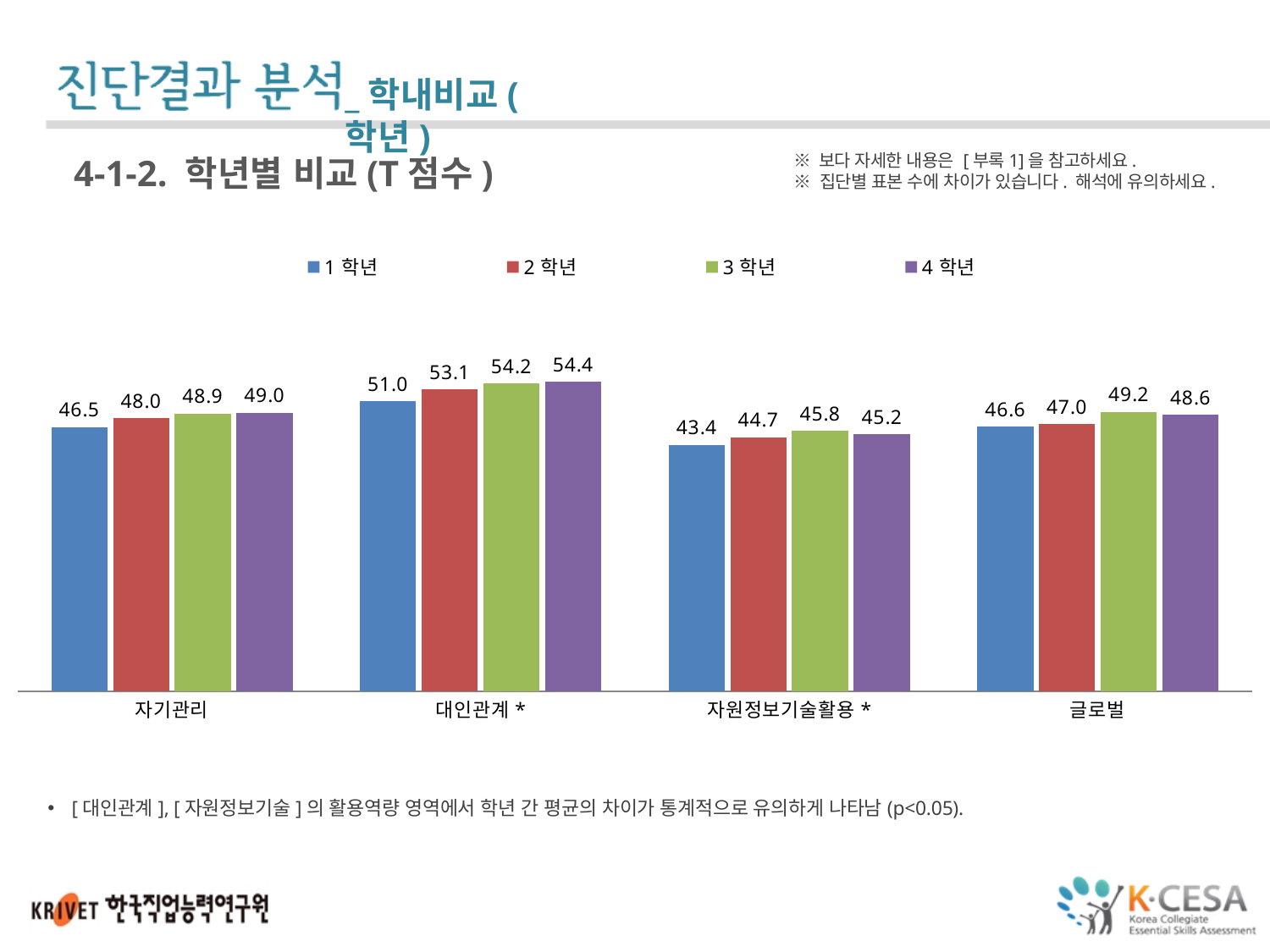
Which category has the highest value for 1 학년? 대인관계 * What is the value for 4 학년 in the 대인관계 * category? 54.4 How many series does the legend list? 4 What is the difference between the 4 학년 and 1 학년 values in the 대인관계 * category? 3.4 How many categories are shown on the x axis of the chart? 4 Which series is shown in green in the legend? 3 학년 What is the value for 1 학년 in the 자기관리 category? 46.5 Which category has the lowest value for 4 학년? 자원정보기술활용 * What is the value for 3 학년 in the 자원정보기술활용 * category? 45.8 What kind of chart is shown on the slide? bar chart What is the value for 2 학년 in the 글로벌 category? 47.0 In the 글로벌 category, which is larger: the value for 3 학년 or the value for 4 학년? 3 학년